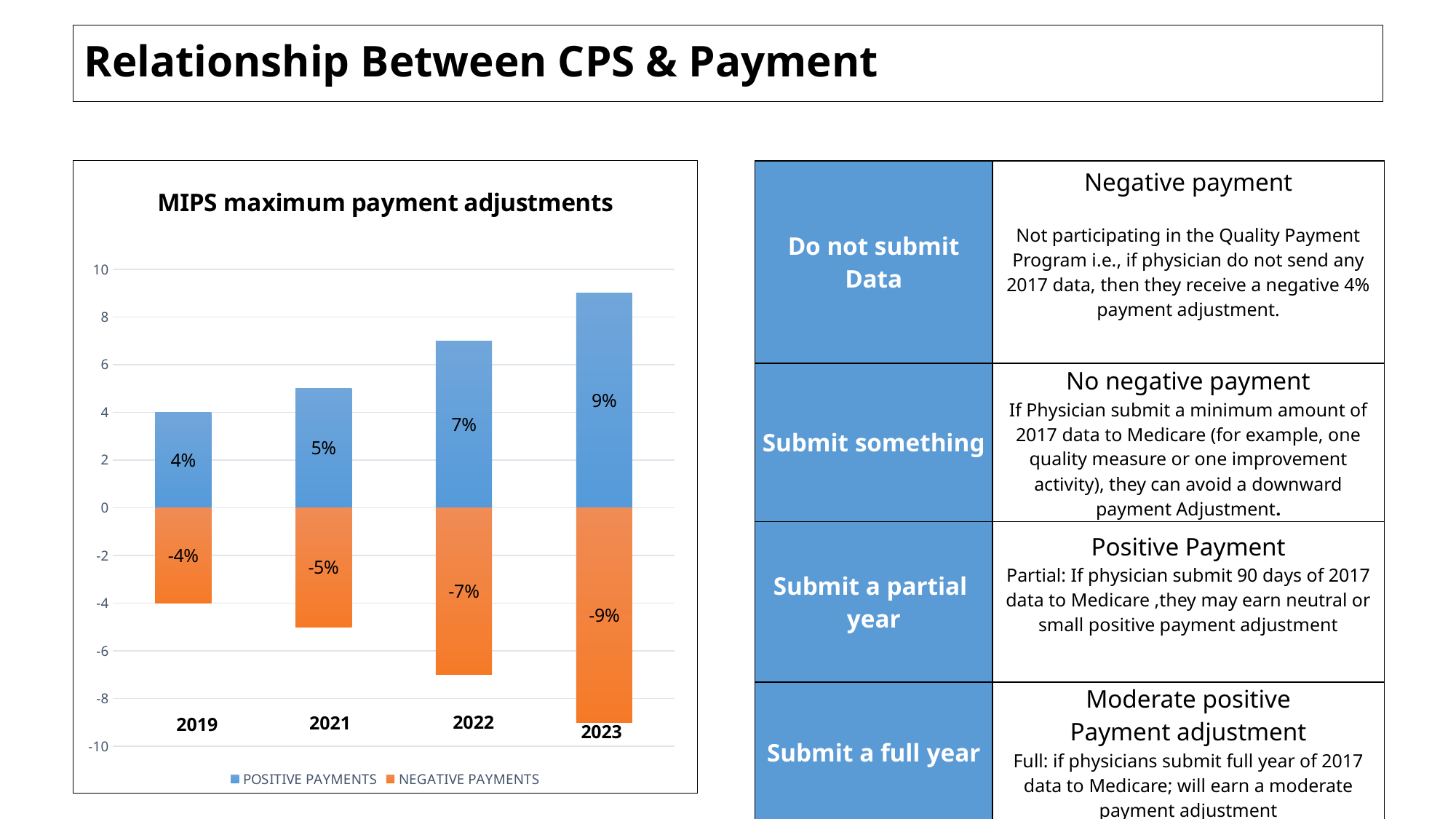
What is the difference between the positive payment adjustment in 2023 and in 2019? 5% What is the negative payment adjustment for 2019? -4% What is the positive payment adjustment for 2023? 9% Which is larger, the positive payment adjustment for 2021 or for 2022? 2022 Do the positive payment adjustments rise or fall from 2019 to 2023? Rise Which year has the lowest positive payment adjustment? 2019 What is the positive payment adjustment for 2021? 5% What kind of chart is shown on the slide? Bar chart How many years are shown on the x axis of the chart? 4 Which year has the highest positive payment adjustment? 2023 What is the negative payment adjustment for 2022? -7% How many series does the chart legend list? 2